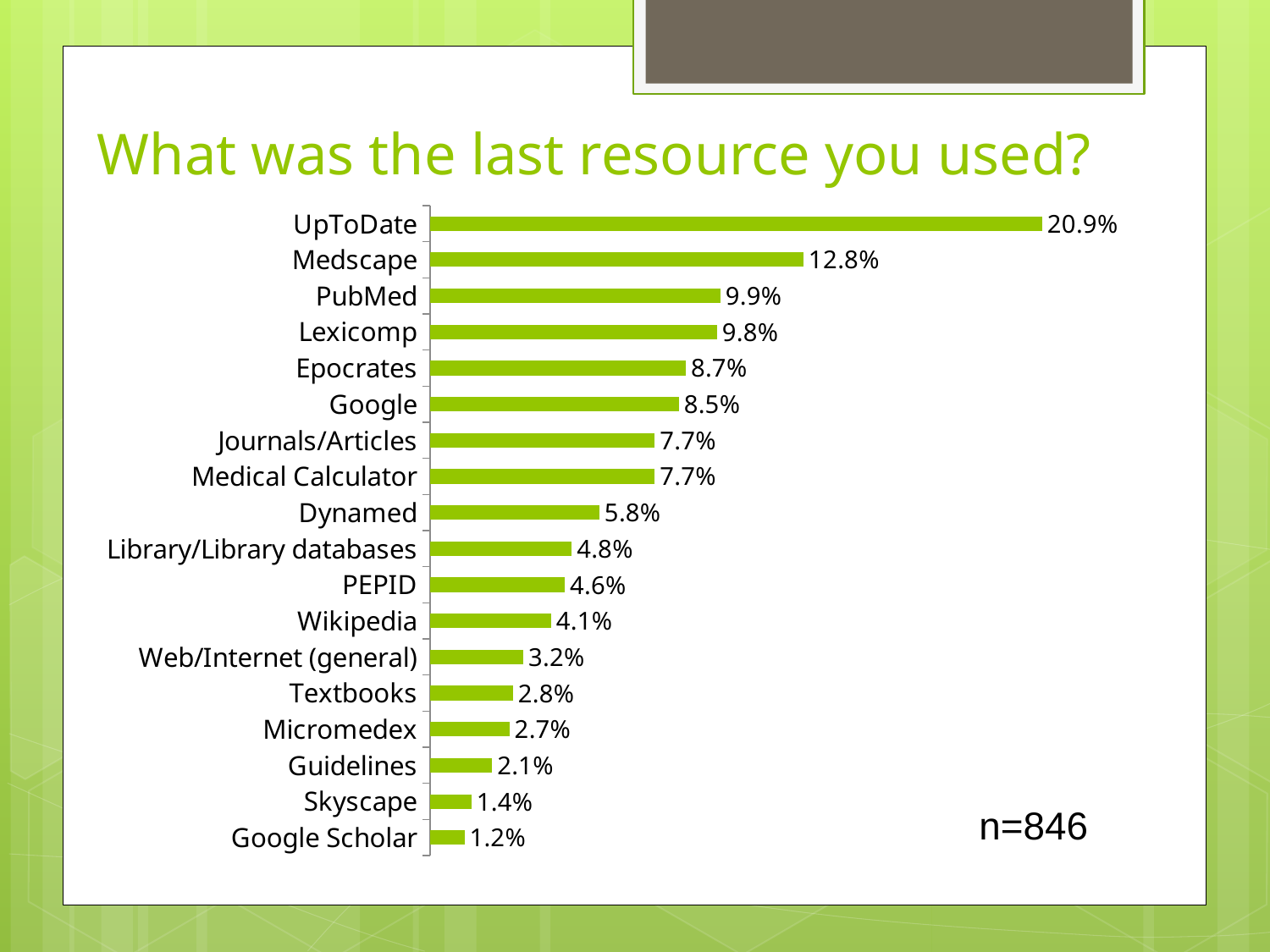
What is the value shown for Epocrates? 8.7% What is the difference between the values for UpToDate and Medscape? 8.1% What percentage of respondents said UpToDate was the last resource they used? 20.9% Which resource has the highest percentage? UpToDate Which has a larger value, Textbooks or Micromedex? Textbooks What is the value shown for Wikipedia? 4.1% What type of chart is shown on the slide? Bar chart How many resources are listed in the chart? 18 Which resource has the lowest percentage? Google Scholar What sample size (n) is shown on the slide? n=846 Which has a larger value, PubMed or Lexicomp? PubMed What is the difference between the values for Google and Dynamed? 2.7%